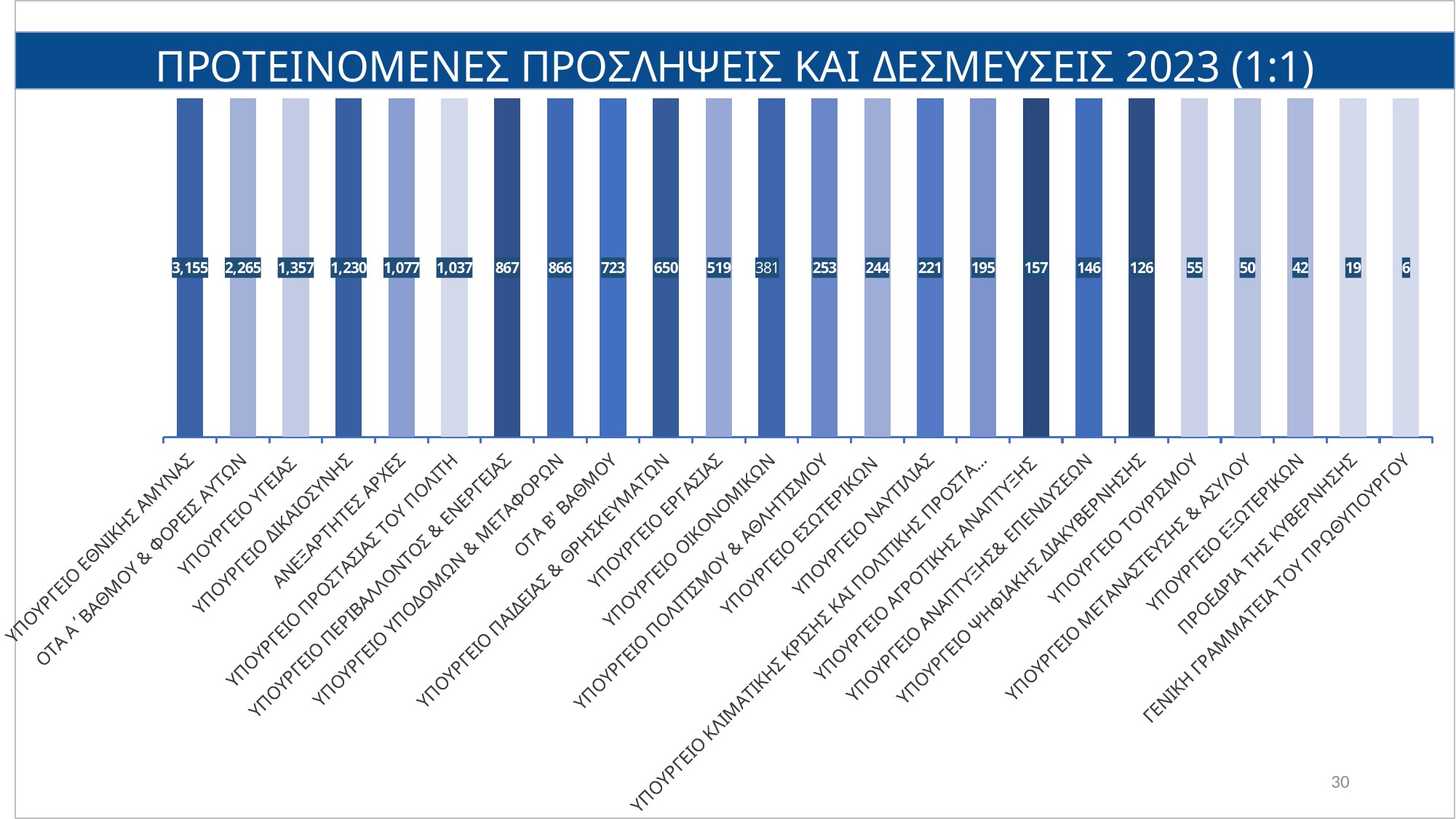
Which category has the highest value? ΥΠΟΥΡΓΕΙΟ ΕΘΝΙΚΗΣ ΑΜΥΝΑΣ Which has a larger value, ΥΠΟΥΡΓΕΙΟ ΕΡΓΑΣΙΑΣ or ΥΠΟΥΡΓΕΙΟ ΝΑΥΤΙΛΙΑΣ? ΥΠΟΥΡΓΕΙΟ ΕΡΓΑΣΙΑΣ What value is shown for ΥΠΟΥΡΓΕΙΟ ΕΘΝΙΚΗΣ ΑΜΥΝΑΣ? 3,155 What is the difference between the values for ΥΠΟΥΡΓΕΙΟ ΕΘΝΙΚΗΣ ΑΜΥΝΑΣ and ΟΤΑ Α΄ ΒΑΘΜΟΥ & ΦΟΡΕΙΣ ΑΥΤΩΝ? 890 What value is shown for ΥΠΟΥΡΓΕΙΟ ΥΓΕΙΑΣ? 1,357 How many categories are shown on the chart? 24 Do the labelled values rise or fall from left to right along the x axis? Fall What kind of chart is shown on the slide? Bar chart Which category has the lowest value? ΓΕΝΙΚΗ ΓΡΑΜΜΑΤΕΙΑ ΤΟΥ ΠΡΩΘΥΠΟΥΡΓΟΥ What is the difference between the values for ΥΠΟΥΡΓΕΙΟ ΔΙΚΑΙΟΣΥΝΗΣ and ΑΝΕΞΑΡΤΗΤΕΣ ΑΡΧΕΣ? 153 What value is shown for ΥΠΟΥΡΓΕΙΟ ΤΟΥΡΙΣΜΟΥ? 55 What value is shown for ΥΠΟΥΡΓΕΙΟ ΟΙΚΟΝΟΜΙΚΩΝ? 381